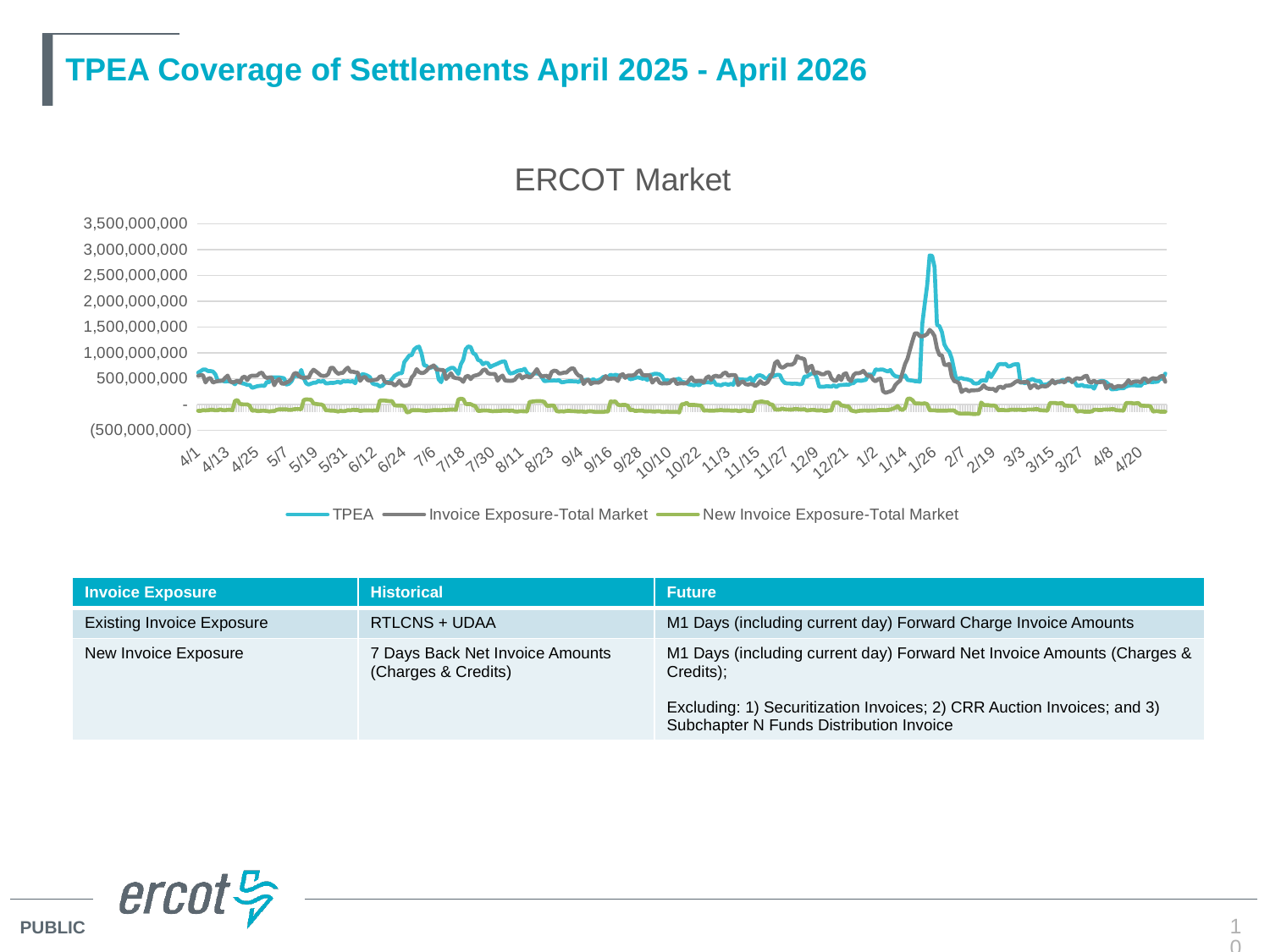
What is the highest value shown on the vertical axis? 3,500,000,000 Is the peak value of the Invoice Exposure-Total Market series around 1/26 greater or less than 2,000,000,000? less Around 1/26, which is larger: the TPEA value or the Invoice Exposure-Total Market value? TPEA Which series has the lowest values across the chart? New Invoice Exposure-Total Market Which series is drawn in green in the chart? New Invoice Exposure-Total Market What kind of chart is shown on the slide? line chart What is the title of the chart? ERCOT Market Which series reaches the highest value anywhere on the chart? TPEA Is the peak value of the TPEA series around 1/26 greater or less than 2,500,000,000? greater Is the TPEA value on 4/1 greater or less than 1,000,000,000? less How many series does the chart legend list? 3